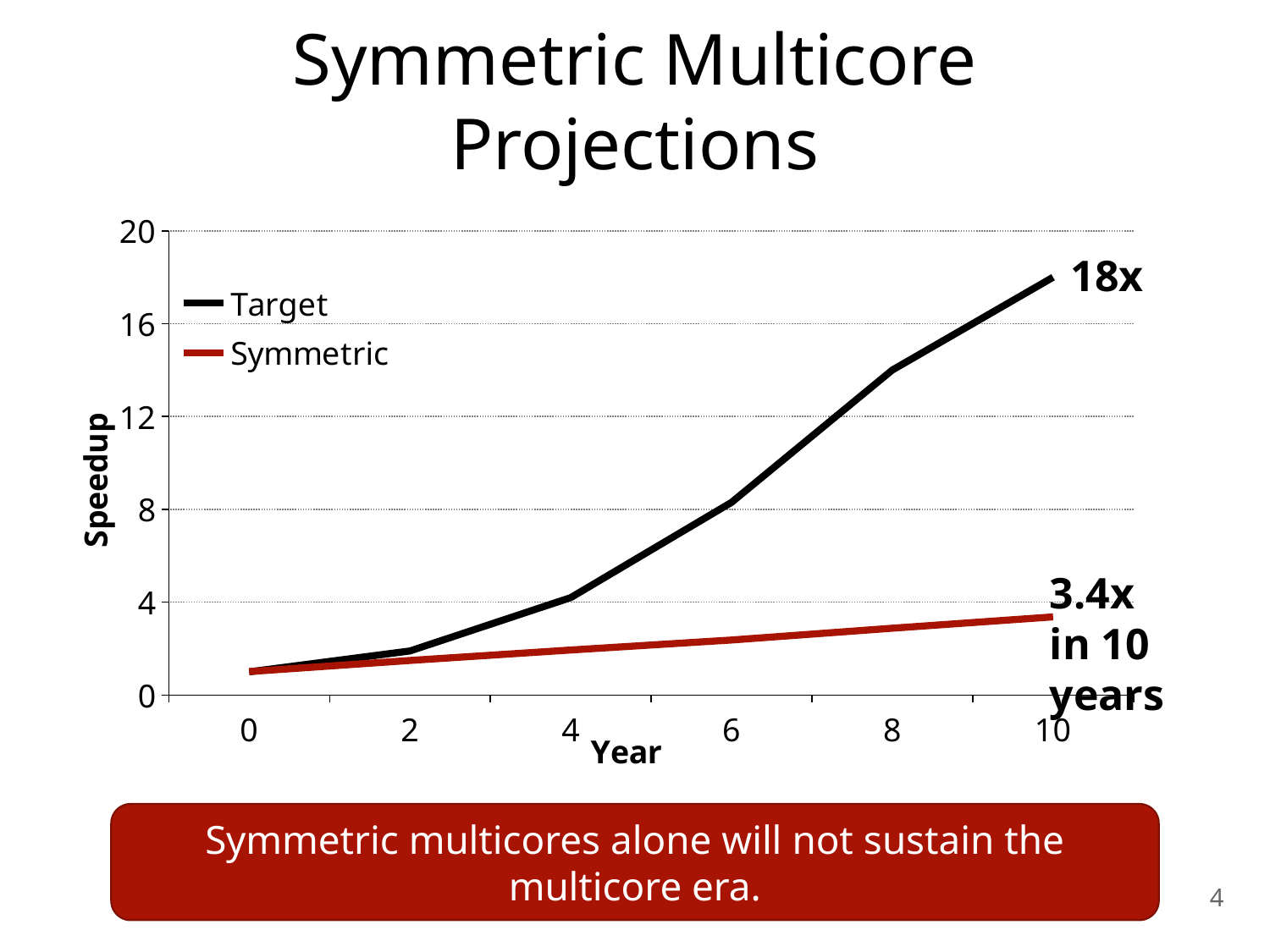
What speedup does the Target series reach at year 10, according to the label on the chart? 18x What speedup does the Symmetric series reach at year 10, according to the label on the chart? 3.4x How many series does the legend list? 2 Which series has the higher speedup at year 10, Target or Symmetric? Target What is the label on the vertical axis? Speedup Is the Target speedup at year 2 greater or less than 4? less Is the Symmetric speedup at year 6 greater or less than 4? less What kind of chart is shown on the slide? line chart Is the Target speedup at year 8 greater or less than 12? greater What is the difference between the Target speedup (18x) and the Symmetric speedup (3.4x) at year 10? 14.6x What are the two series named in the legend? Target and Symmetric Does the Target series rise or fall as the year increases from 0 to 10? rise